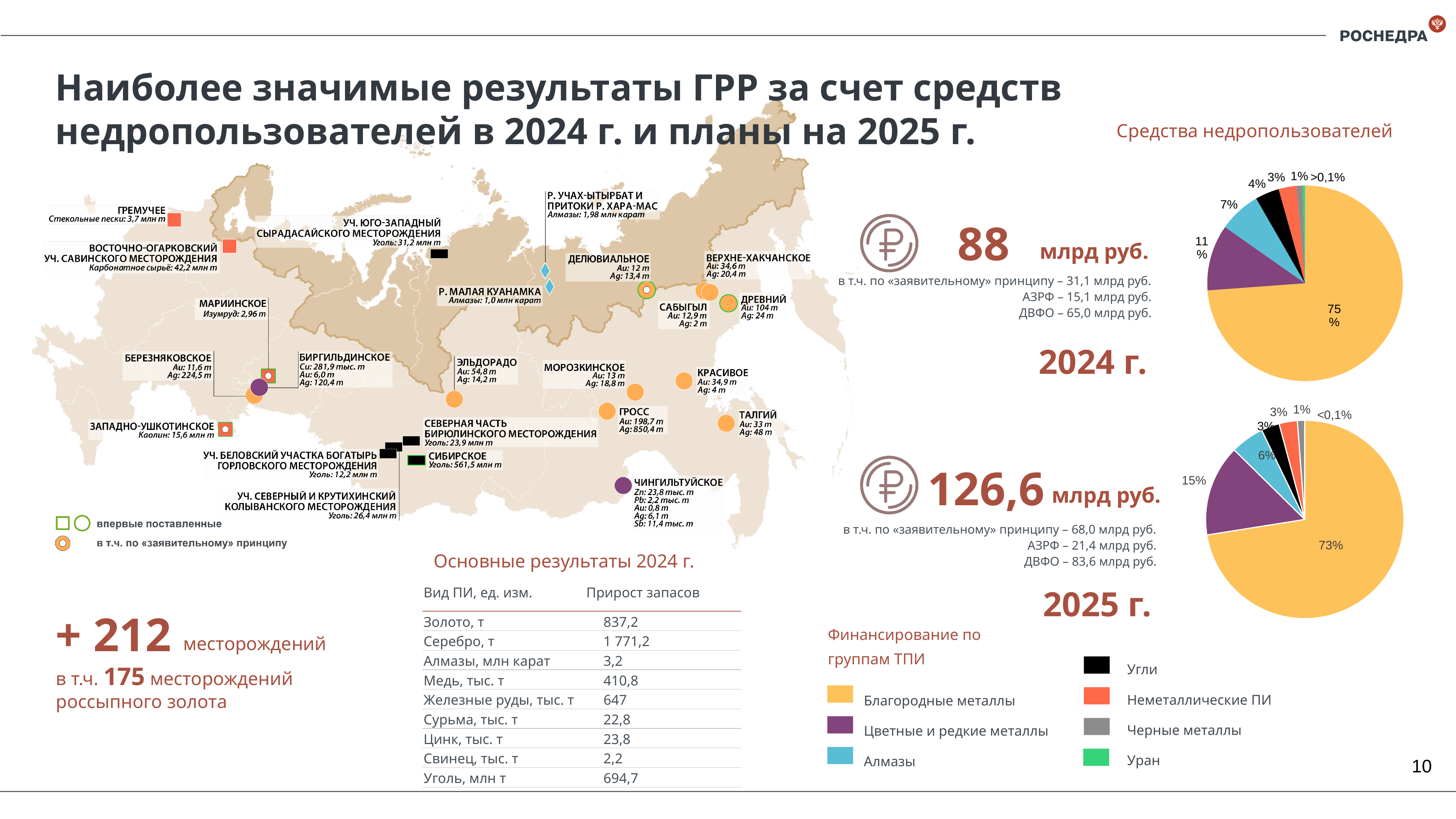
In the 2024 г. pie chart, what share is shown for Цветные и редкие металлы? 11% In the 2025 г. pie chart, which group has the smallest share? Уран How many groups of ТПИ does the legend for the pie charts list? 7 In the 2024 г. pie chart, what share is shown for Благородные металлы? 75% Is the share of Алмазы larger in the 2024 г. pie chart or in the 2025 г. pie chart? 2024 г. In the 2024 г. pie chart, what share is shown for Алмазы? 7% What kind of chart is used to show «Средства недропользователей» for 2024 г. and 2025 г.? pie chart In the 2025 г. pie chart, what share is shown for Цветные и редкие металлы? 15% What is the difference between the share of Цветные и редкие металлы in the 2025 г. pie chart and in the 2024 г. pie chart? 4 percentage points In the 2025 г. pie chart, what share is shown for Благородные металлы? 73% In the 2024 г. pie chart, which group has the largest share? Благородные металлы In the 2025 г. pie chart, what share is shown for Алмазы? 6%